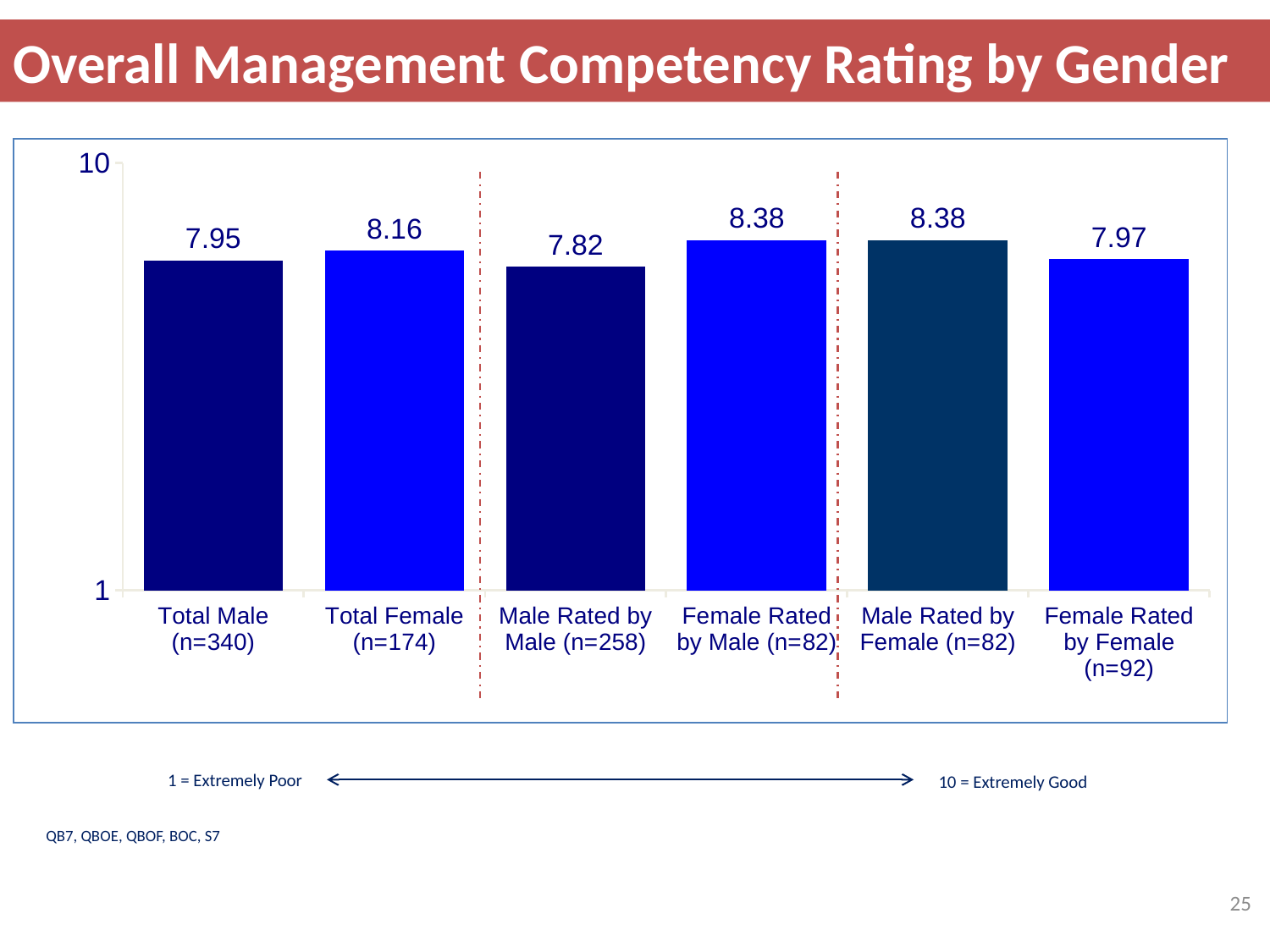
What is the difference between the Total Female rating and the Total Male rating? 0.21 What is the difference between the Female Rated by Male rating and the Male Rated by Male rating? 0.56 What type of chart is shown on the slide? Bar chart Which two categories share the highest rating of 8.38? Female Rated by Male (n=82) and Male Rated by Female (n=82) How many categories are shown in the chart? 6 Which is higher, the rating for Total Female or for Total Male? Total Female What is the overall management competency rating for Total Male (n=340)? 7.95 What is the rating for Female Rated by Female (n=92)? 7.97 What is the title of the chart? Overall Management Competency Rating by Gender What is the rating for Total Female (n=174)? 8.16 What is the rating for Male Rated by Male (n=258)? 7.82 Which category has the lowest rating? Male Rated by Male (n=258)